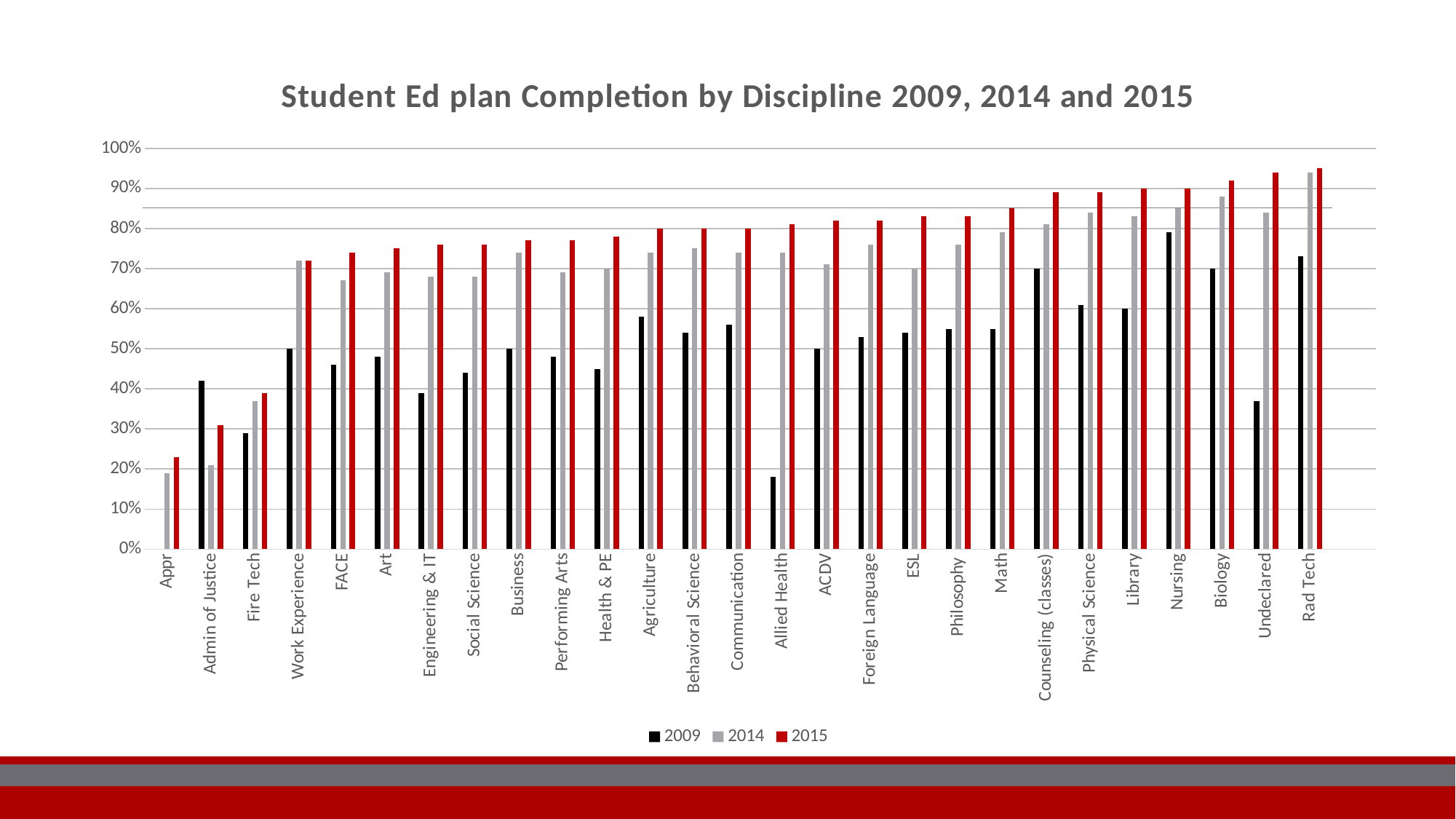
Which discipline has the highest 2015 value? Rad Tech What is the title of the chart? Student Ed plan Completion by Discipline 2009, 2014 and 2015 Is the 2009 value for Allied Health greater or less than 20%? less Is the 2015 value for Rad Tech greater or less than 90%? greater Which discipline has the lowest 2015 value? Appr Which discipline has the highest 2009 value? Nursing For Undeclared, which is larger: the 2009 value or the 2014 value? 2014 How many disciplines are shown on the x axis? 27 How many series does the legend list? 3 What kind of chart is shown on the slide? bar chart Which discipline has the lowest 2009 value? Allied Health Do the 2015 values generally rise or fall moving left to right along the x axis? rise